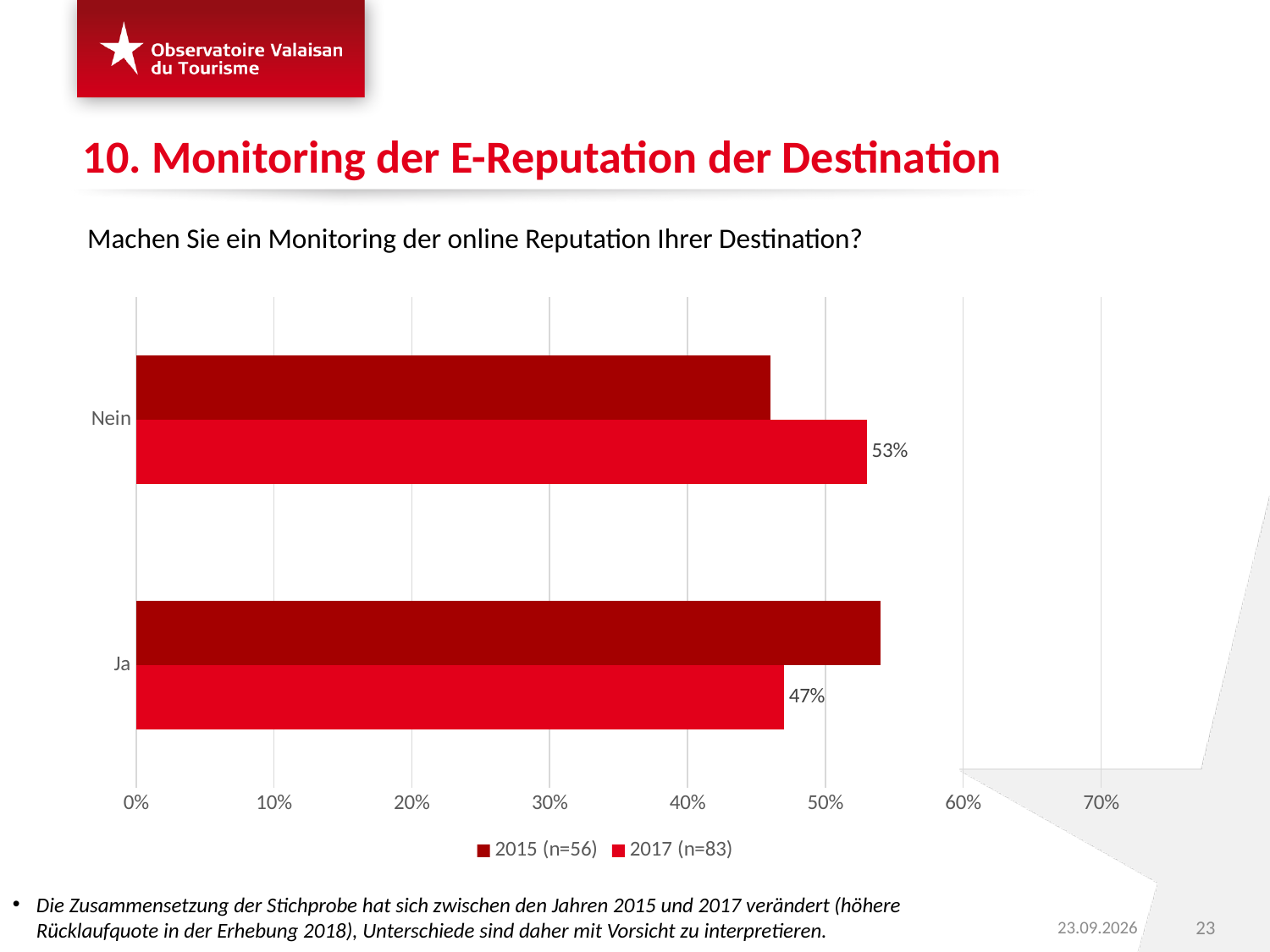
Is the 2015 (n=56) value for "Nein" greater or less than 50%? less What is the value for "Nein" in the 2017 (n=83) series? 53% What is the value for "Ja" in the 2017 (n=83) series? 47% How many series does the legend list? 2 For the category "Nein", which series has the larger value, 2015 (n=56) or 2017 (n=83)? 2017 (n=83) What kind of chart is shown on the slide? Bar chart How many categories are shown on the chart? 2 What are the two legend entries of the chart? 2015 (n=56) and 2017 (n=83) Is the 2015 (n=56) value for "Ja" greater or less than 50%? greater In the 2017 (n=83) series, which category has the higher value, "Nein" or "Ja"? Nein What is the difference between the 2017 (n=83) values for "Nein" and "Ja"? 6 percentage points For the category "Ja", which series has the larger value, 2015 (n=56) or 2017 (n=83)? 2015 (n=56)